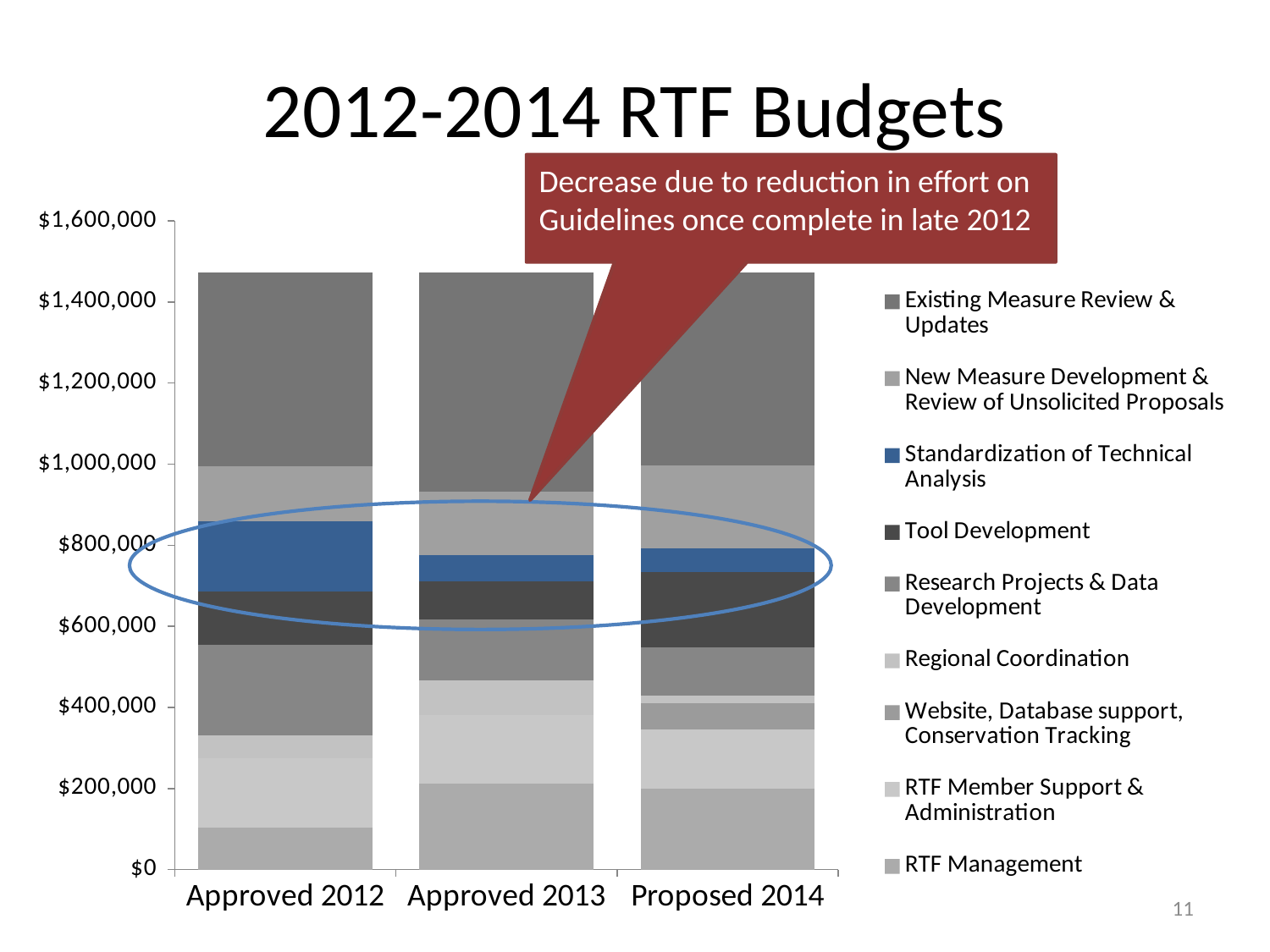
Is the total budget for Proposed 2014 greater or less than $1,600,000? less Is the total budget for Approved 2012 greater or less than $1,400,000? greater Is the Standardization of Technical Analysis segment larger for Approved 2012 or Approved 2013? Approved 2012 Which budget year has the largest Standardization of Technical Analysis segment? Approved 2012 What kind of chart is shown on the slide? Stacked bar chart What is the title of the chart on the slide? 2012-2014 RTF Budgets Does the Standardization of Technical Analysis segment rise or fall from Approved 2012 to Approved 2013? fall How many budget years (categories) are shown on the x axis? 3 How many series does the legend list? 9 Is the RTF Management segment larger for Approved 2012 or Approved 2013? Approved 2013 Is the RTF Management segment for Approved 2012 greater or less than $200,000? less Which series is shown in blue in the chart? Standardization of Technical Analysis